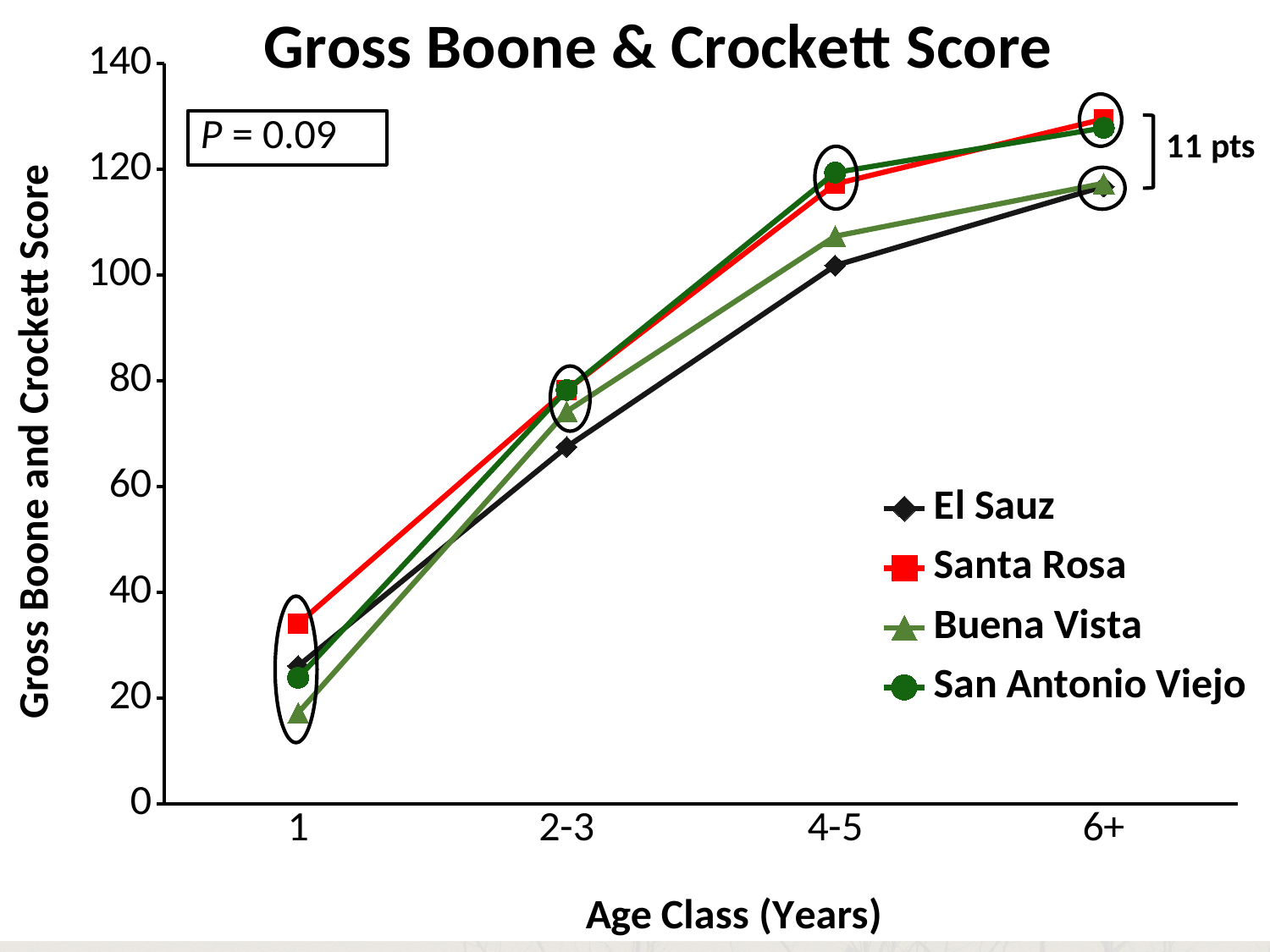
Is the value for Buena Vista at age class 1 greater or less than 20? less Which ranch has the lowest score at age class 2-3? El Sauz How many series does the legend list? 4 How many age classes are shown on the x axis? 4 Is the value for Santa Rosa at age class 6+ greater or less than 120? greater Which ranch has the lowest score at age class 1? Buena Vista What P value is shown in the box on the chart? P = 0.09 Is the value for El Sauz at age class 2-3 greater or less than 80? less Do the Gross Boone and Crockett scores rise or fall as age class increases? rise What kind of chart is shown on the slide? line chart Which ranch has the highest score at age class 1? Santa Rosa At age class 4-5, which is larger: the value for Santa Rosa or the value for El Sauz? Santa Rosa